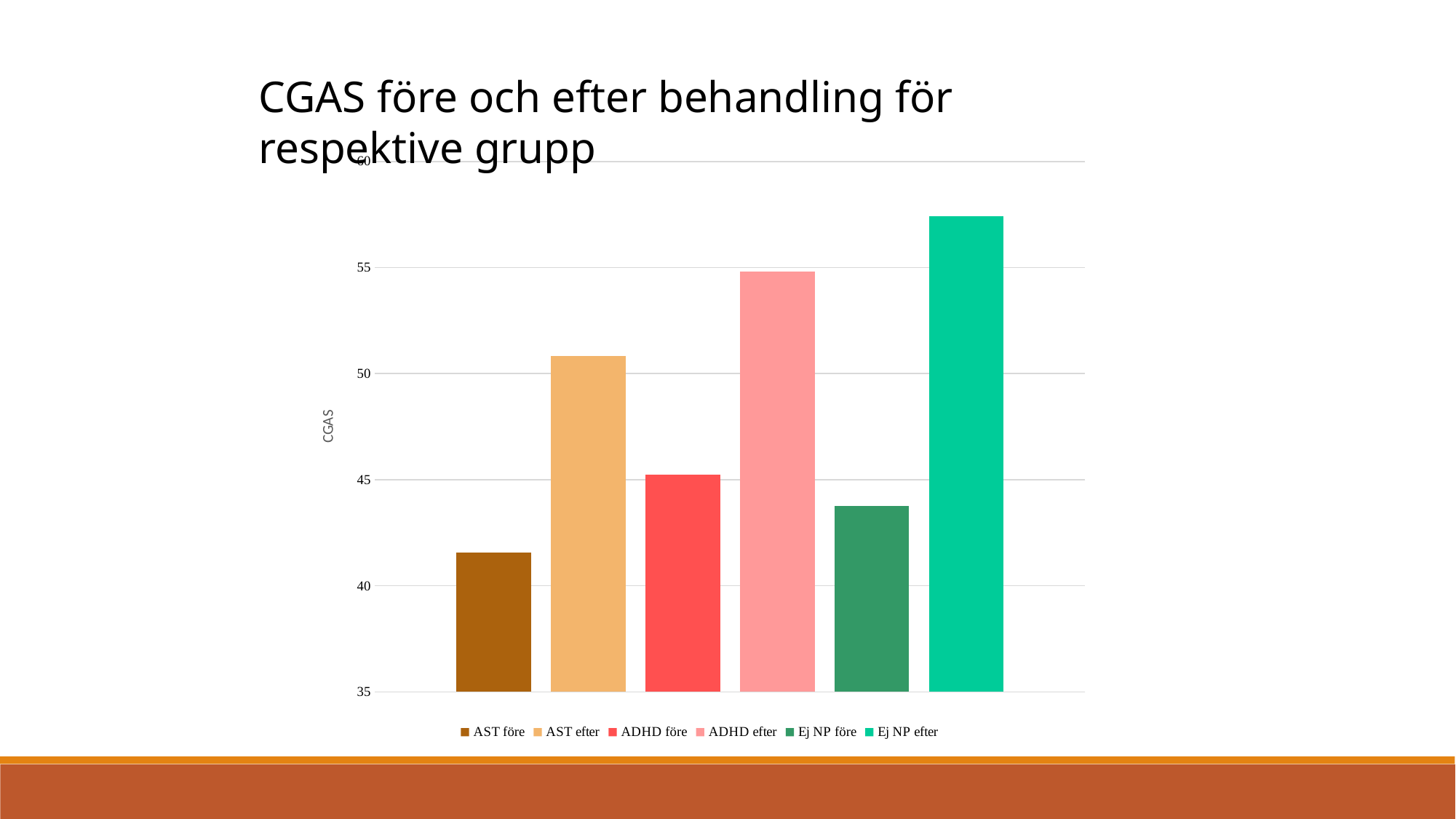
Is the value for Ej NP före greater or less than 45? less What is the label on the vertical axis of the chart? CGAS Is the value for AST före greater or less than 45? less Is the value for AST efter greater or less than 50? greater Which is larger, the value for AST efter or the value for ADHD efter? ADHD efter How many entries does the legend list? 6 Which group has the lowest CGAS value? AST före Which group has the highest CGAS value? Ej NP efter How many bars are plotted in the chart? 6 What kind of chart is shown on the slide? bar chart